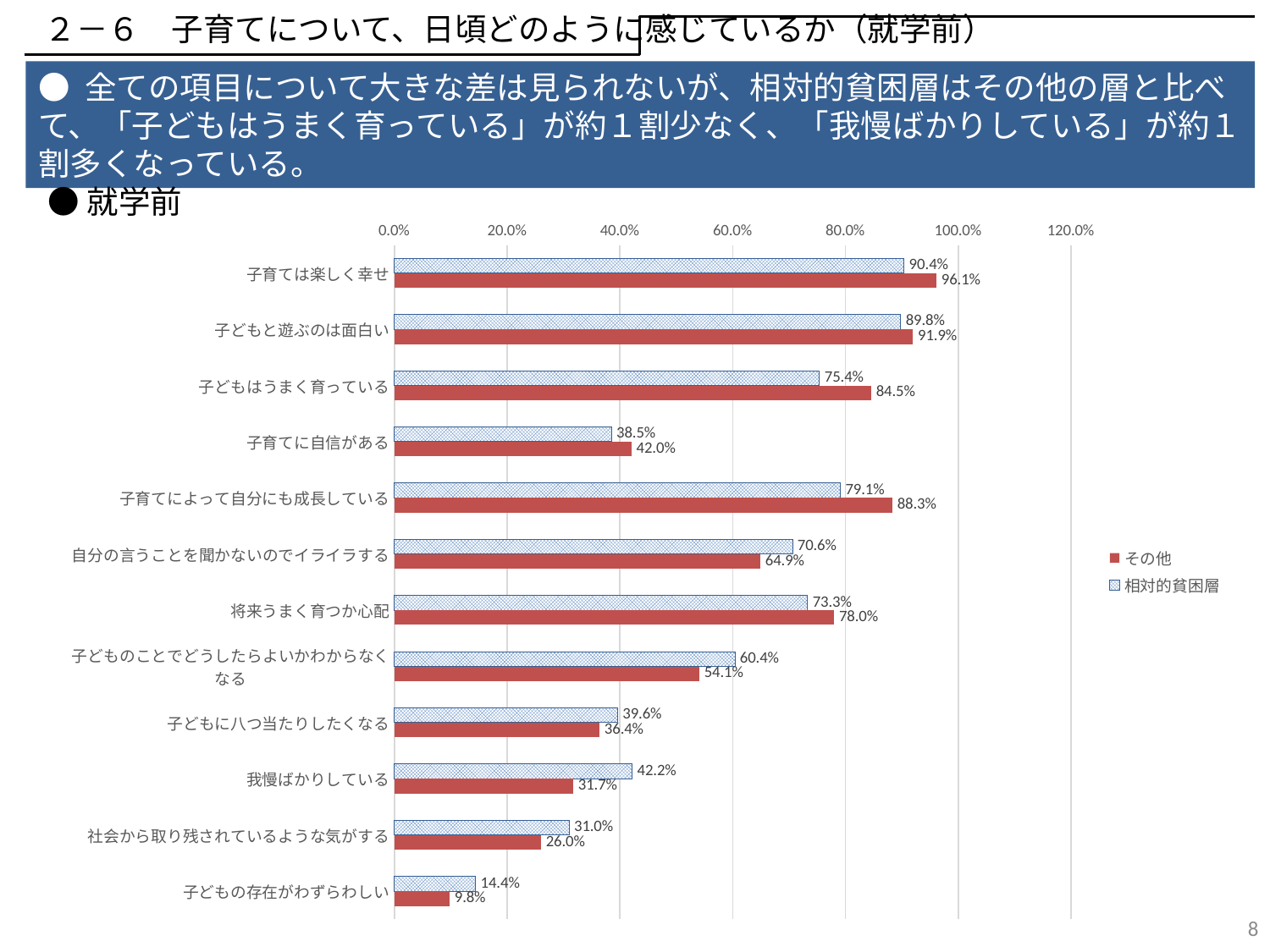
What kind of chart is shown on the slide? bar chart What is the value for その他 in the category 子育ては楽しく幸せ? 96.1% Is the value for その他 in the category 子育てによって自分にも成長している greater or less than 80.0%? greater In the category 自分の言うことを聞かないのでイライラする, which series has the larger value, その他 or 相対的貧困層? 相対的貧困層 What is the value for 相対的貧困層 in the category 子どもはうまく育っている? 75.4% What is the difference between その他 and 相対的貧困層 in the category 我慢ばかりしている? 10.5% Which category has the highest value for その他? 子育ては楽しく幸せ How many categories are shown on the chart? 12 Which category has the lowest value for 相対的貧困層? 子どもの存在がわずらわしい What is the value for 相対的貧困層 in the category 我慢ばかりしている? 42.2% What is the difference between その他 and 相対的貧困層 in the category 子どもはうまく育っている? 9.1% How many series does the legend list? 2